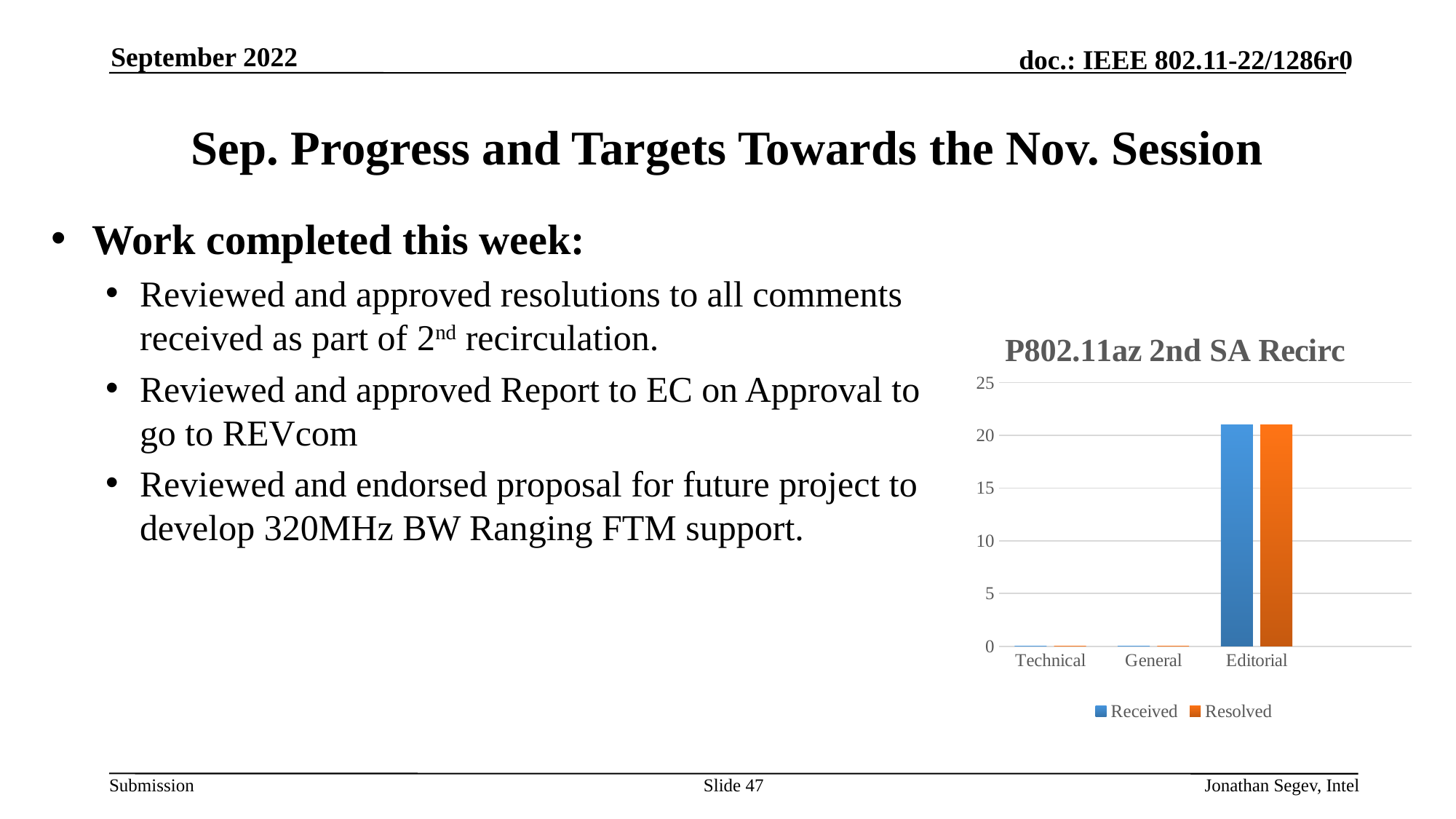
Which category has the highest Resolved value? Editorial Is the Received value for Technical greater or less than 5? less Which category has the highest Received value? Editorial What kind of chart is shown on the slide? bar chart Is the Received value for Editorial greater or less than 15? greater Which series is shown in orange in the chart? Resolved What is the title of the chart? P802.11az 2nd SA Recirc Is the Resolved value for Editorial greater or less than 25? less Which is larger, the Received value for Editorial or the Received value for General? Editorial How many series does the chart legend list? 2 How many categories are shown on the x axis of the chart? 3